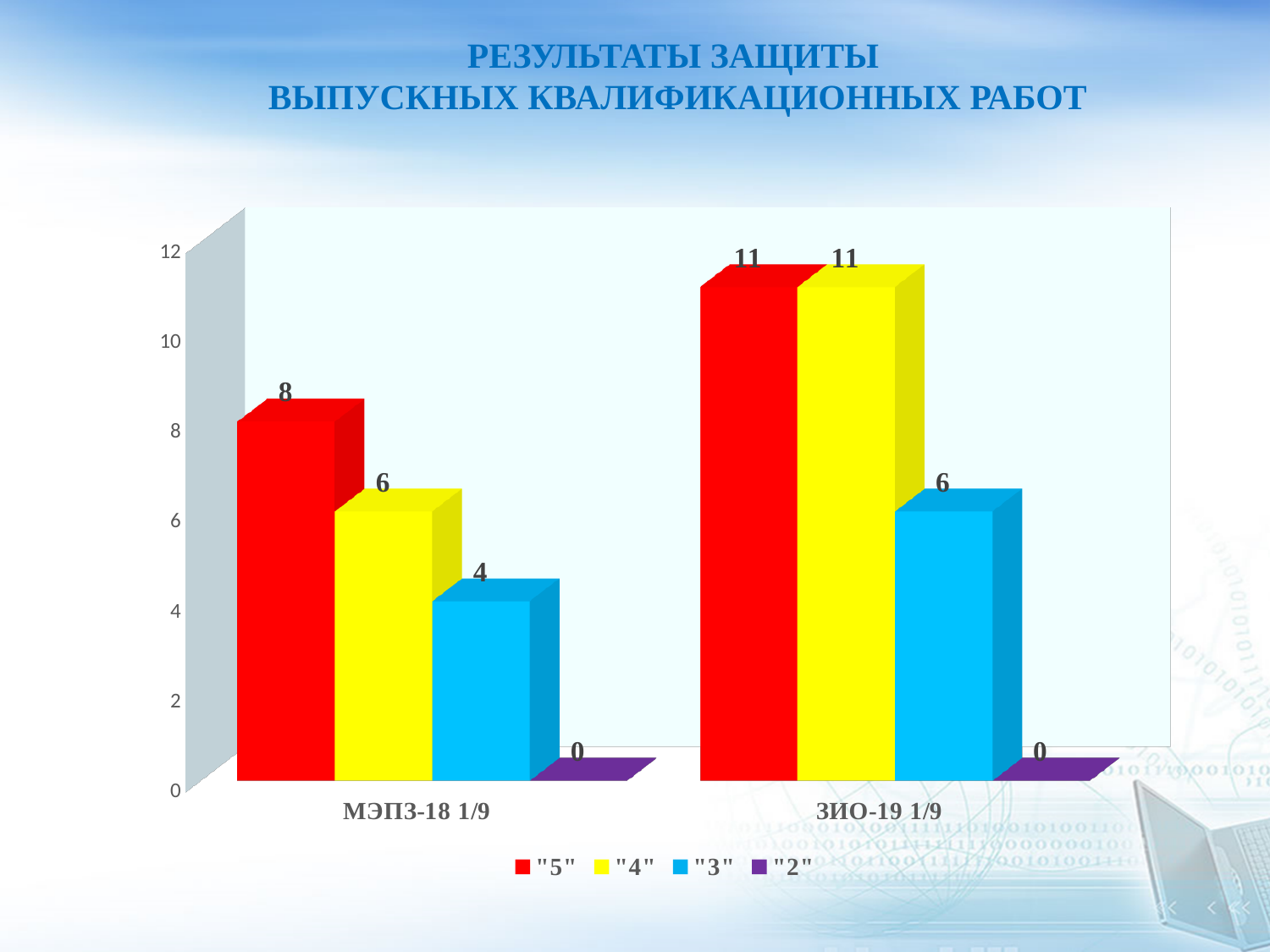
How many categories are shown on the x axis? 2 Which is larger: the "3" value for МЭПЗ-18 1/9 or the "3" value for ЗИО-19 1/9? ЗИО-19 1/9 What is the value for "3" in the ЗИО-19 1/9 group? 6 What is the value for "4" in the МЭПЗ-18 1/9 group? 6 Which series has the lowest value in the МЭПЗ-18 1/9 group? "2" What kind of chart is shown on the slide? bar chart What is the total of all four values in the ЗИО-19 1/9 group? 28 How many series does the legend list? 4 What colour represents the "4" series in the legend? yellow What is the value for "5" in the МЭПЗ-18 1/9 group? 8 What is the difference between the "5" values for ЗИО-19 1/9 and МЭПЗ-18 1/9? 3 What is the value for "2" in the ЗИО-19 1/9 group? 0